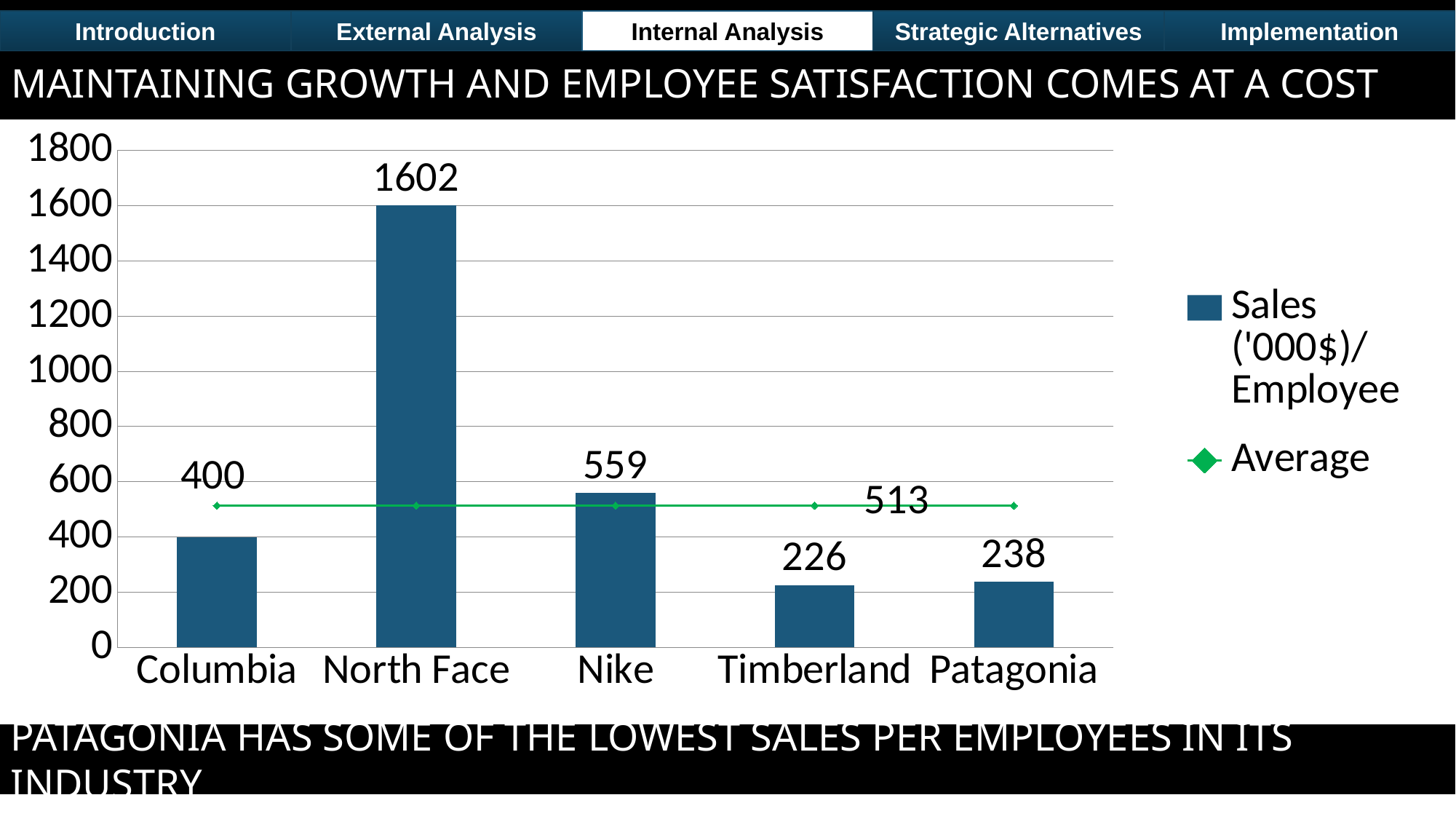
How many companies are shown on the x axis? 5 What value is shown for the Average line? 513 What is the Sales ('000$)/Employee value for Columbia? 400 What is the difference in Sales ('000$)/Employee between Nike and Patagonia? 321 What is the Sales ('000$)/Employee value for North Face? 1602 What is the Sales ('000$)/Employee value for Patagonia? 238 Is the Sales ('000$)/Employee value for Timberland greater or less than the Average of 513? less Which company has the highest Sales ('000$)/Employee? North Face How many series does the legend list? 2 What type of chart is used to show the Sales ('000$)/Employee values? Bar chart Which has a higher Sales ('000$)/Employee value, Columbia or Nike? Nike Which company has the lowest Sales ('000$)/Employee? Timberland